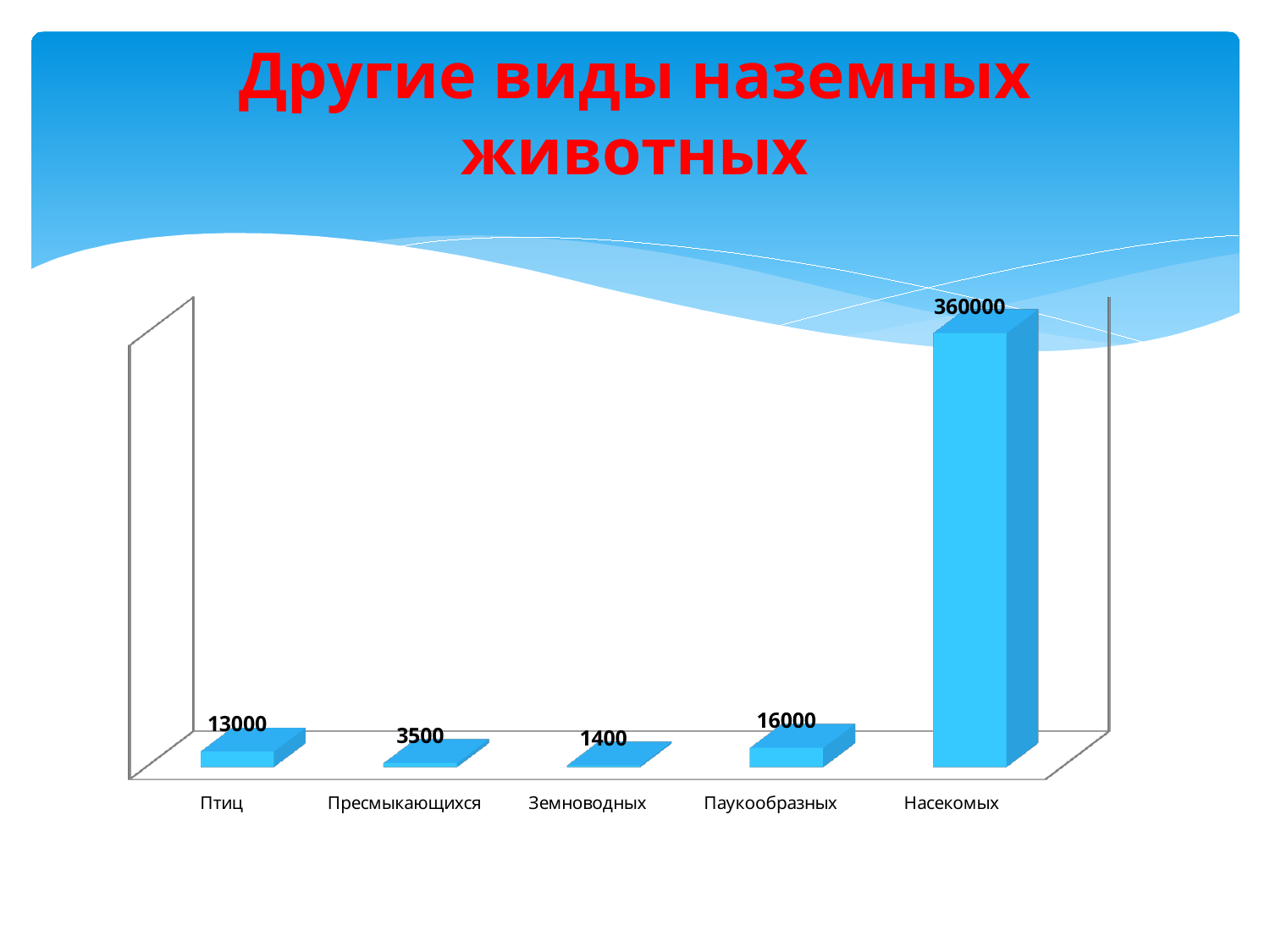
What kind of chart is shown on the slide? Bar chart What is the value for Пресмыкающихся? 3500 What is the value for Паукообразных? 16000 What is the difference between the values for Птиц and Пресмыкающихся? 9500 How many categories are shown in the chart? 5 What is the value for Земноводных? 1400 Which category has the lowest value? Земноводных What is the difference between the values for Насекомых and Паукообразных? 344000 Which category has the highest value? Насекомых What is the value for Насекомых? 360000 What is the value for Птиц? 13000 Which is larger, the value for Птиц or the value for Паукообразных? Паукообразных